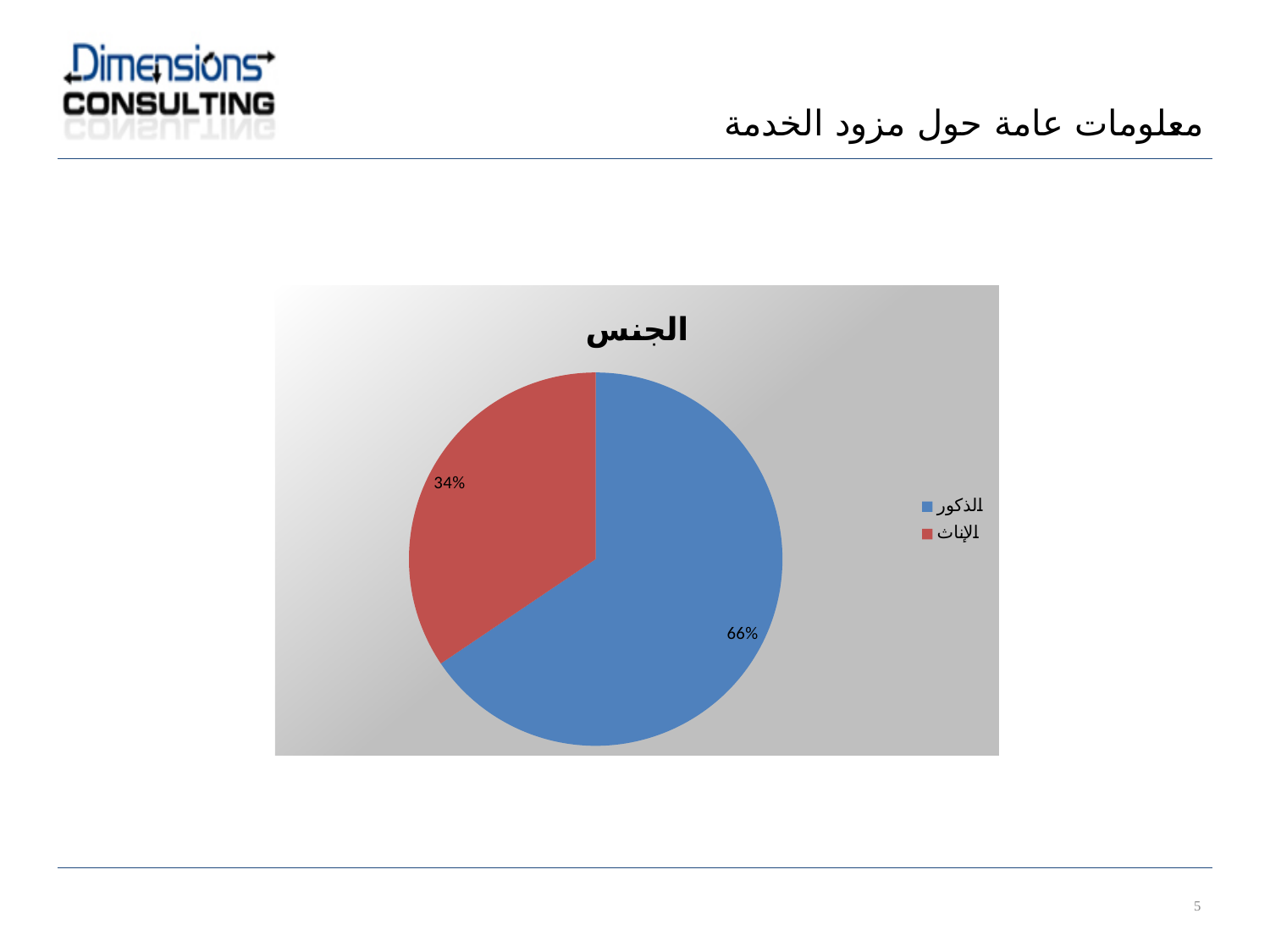
How many slices does the pie chart have? 2 Which category has the smallest slice of the pie? الإناث What kind of chart is shown on the slide? pie chart Which category has the largest slice of the pie? الذكور What is the title of the chart? الجنس Which slice is larger, الذكور or الإناث? الذكور How many entries does the legend list? 2 What share of the pie does الإناث (females) take? 34% What colour is the الإناث slice? red What is the difference in percentage points between the الذكور slice and the الإناث slice? 32% What share of the pie does الذكور (males) take? 66%